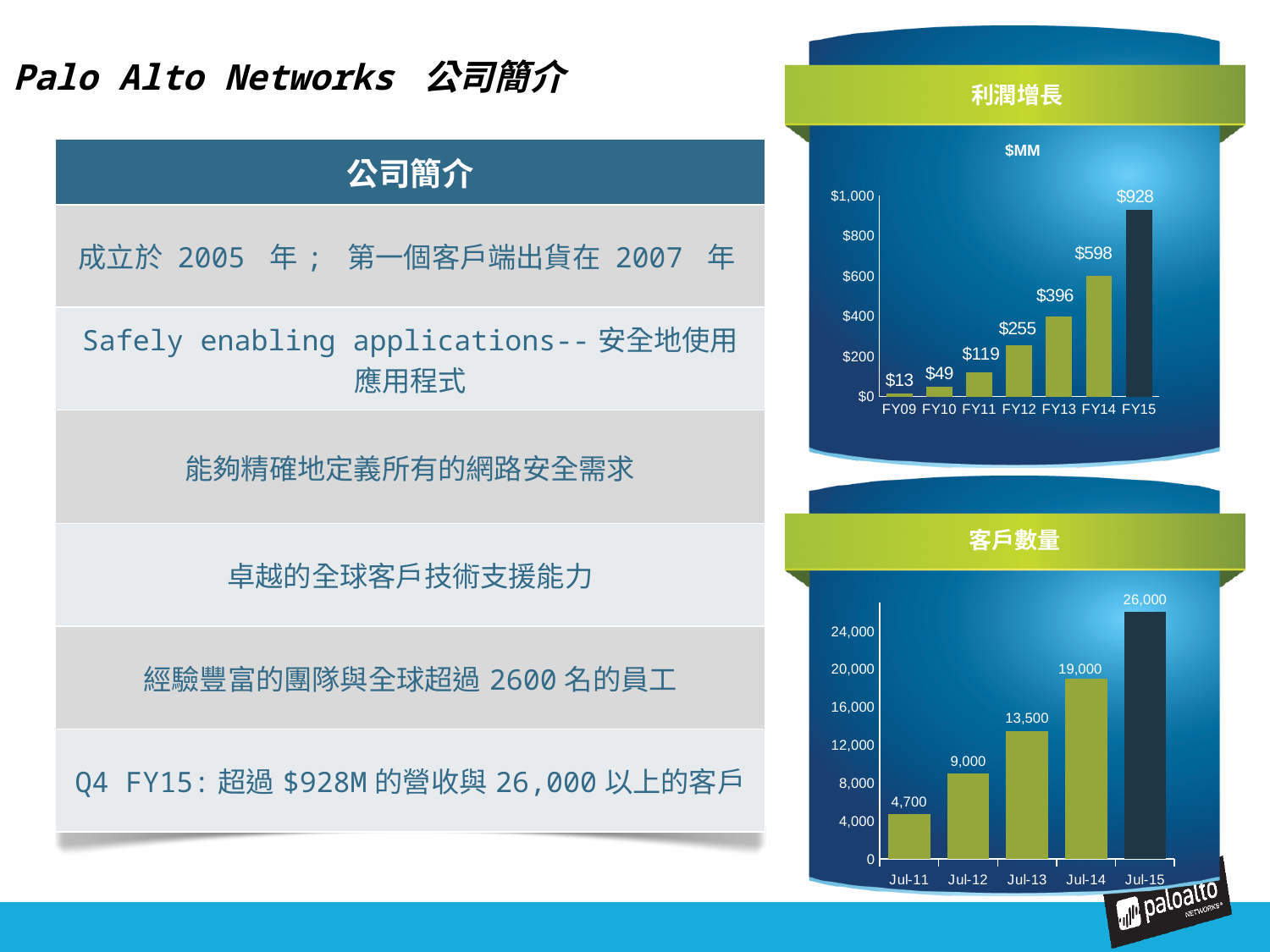
In the 客戶數量 chart, which is larger, the value for Jul-12 or the value for Jul-13? Jul-13 In the 利潤增長 chart, how many fiscal years are shown on the x axis? 7 What kind of chart is the 客戶數量 chart? bar chart In the 客戶數量 chart, what is the difference between the Jul-15 and Jul-14 values? 7,000 In the 客戶數量 chart, what is the value for Jul-13? 13,500 In the 利潤增長 chart, what is the value for FY09? $13 In the 客戶數量 chart, which period has the lowest value? Jul-11 In the 利潤增長 chart, what is the difference between the FY15 and FY14 values? $330 In the 利潤增長 chart, what unit label is shown above the plot area? $MM In the 利潤增長 chart, what is the value for FY13? $396 In the 利潤增長 chart, which fiscal year has the highest value? FY15 In the 利潤增長 chart, do the values rise or fall from FY09 to FY15? rise